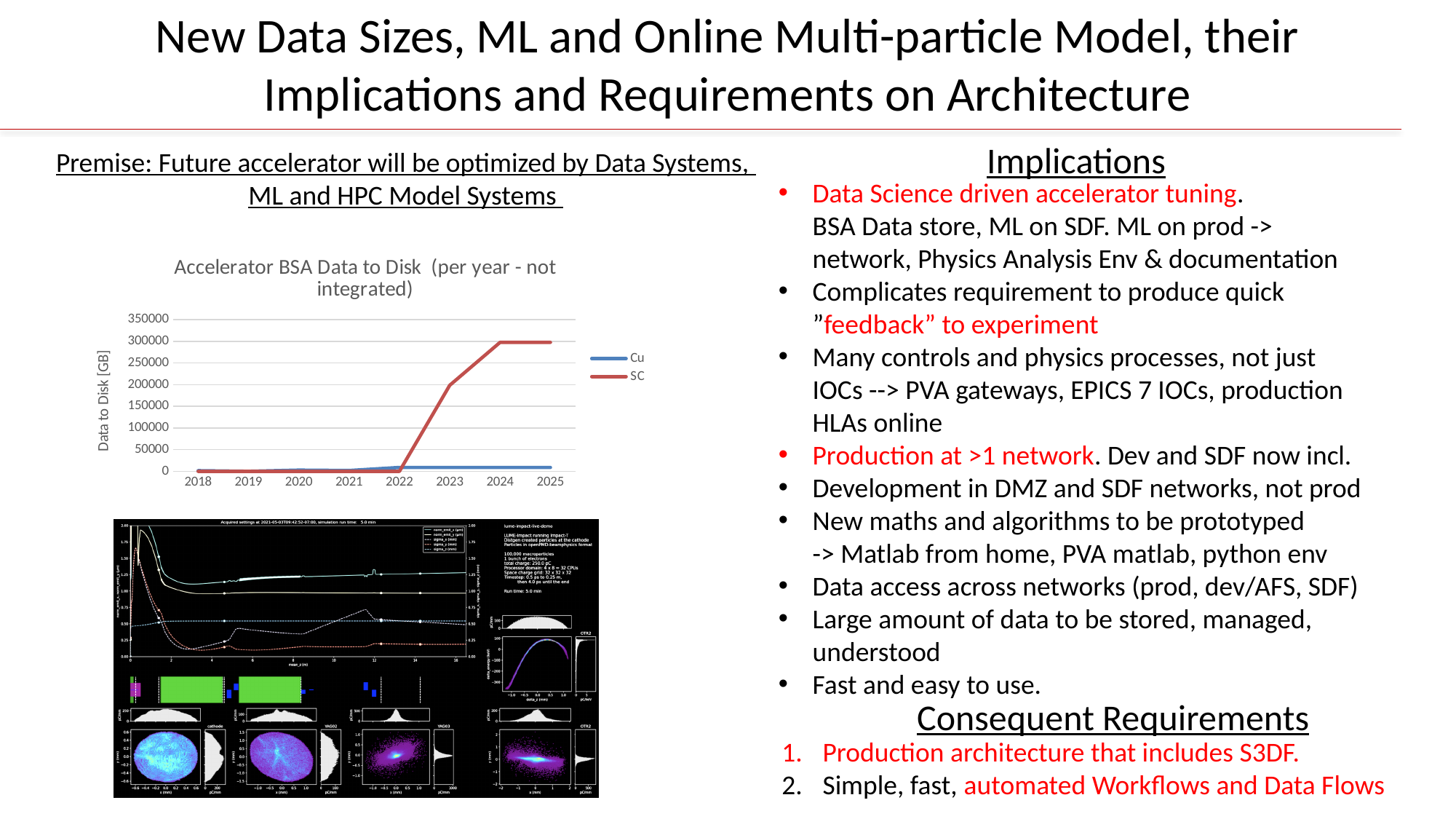
In the 'Accelerator BSA Data to Disk' chart, is the SC value for 2021 greater or less than 50000? less What kind of chart is the 'Accelerator BSA Data to Disk' chart? line chart In the 'Accelerator BSA Data to Disk' chart, is the SC value for 2023 greater or less than 150000? greater How many series does the legend of the 'Accelerator BSA Data to Disk' chart list? 2 In the 'Accelerator BSA Data to Disk' chart, does the SC series rise or fall from 2022 to 2024? rise How many years are shown on the x axis of the 'Accelerator BSA Data to Disk' chart? 8 What is the label of the y axis on the 'Accelerator BSA Data to Disk' chart? Data to Disk [GB] In the 'Accelerator BSA Data to Disk' chart, which series has the higher value in 2025, Cu or SC? SC In the 'Accelerator BSA Data to Disk' chart, which series has the higher value in 2023, Cu or SC? SC In the 'Accelerator BSA Data to Disk' chart, is the SC value for 2024 greater or less than 250000? greater Which series are listed in the legend of the 'Accelerator BSA Data to Disk' chart? Cu and SC